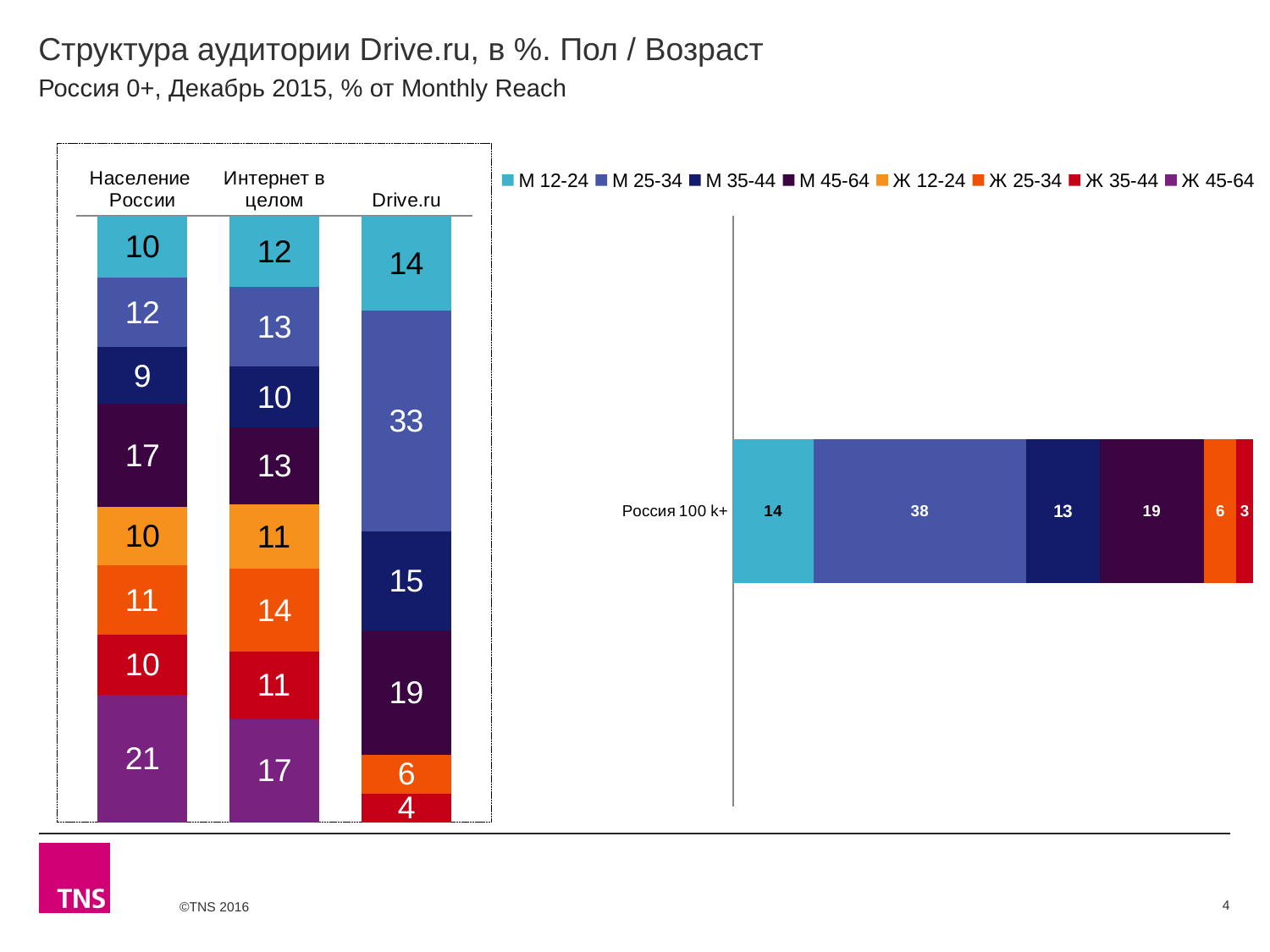
In the left chart, which segment is the smallest in the Население России column? М 35-44 In the left chart, what is the value for Ж 45-64 in the Население России column? 21 In the left chart, which segment is the largest in the Drive.ru column? М 25-34 In the left chart, which is larger: М 45-64 for Drive.ru or М 45-64 for Интернет в целом? Drive.ru How many columns (categories) are shown in the left chart? 3 What kind of chart is the right chart (Россия 100 k+)? Stacked bar chart In the left chart, what is the value for Ж 25-34 in the Интернет в целом column? 14 In the right chart (Россия 100 k+), what is the value for М 25-34? 38 How many series does the legend list? 8 In the left chart, what is the value for М 25-34 in the Drive.ru column? 33 In the left chart, what is the difference between М 25-34 for Drive.ru and М 25-34 for Население России? 21 In the right chart (Россия 100 k+), what is the value for М 45-64? 19